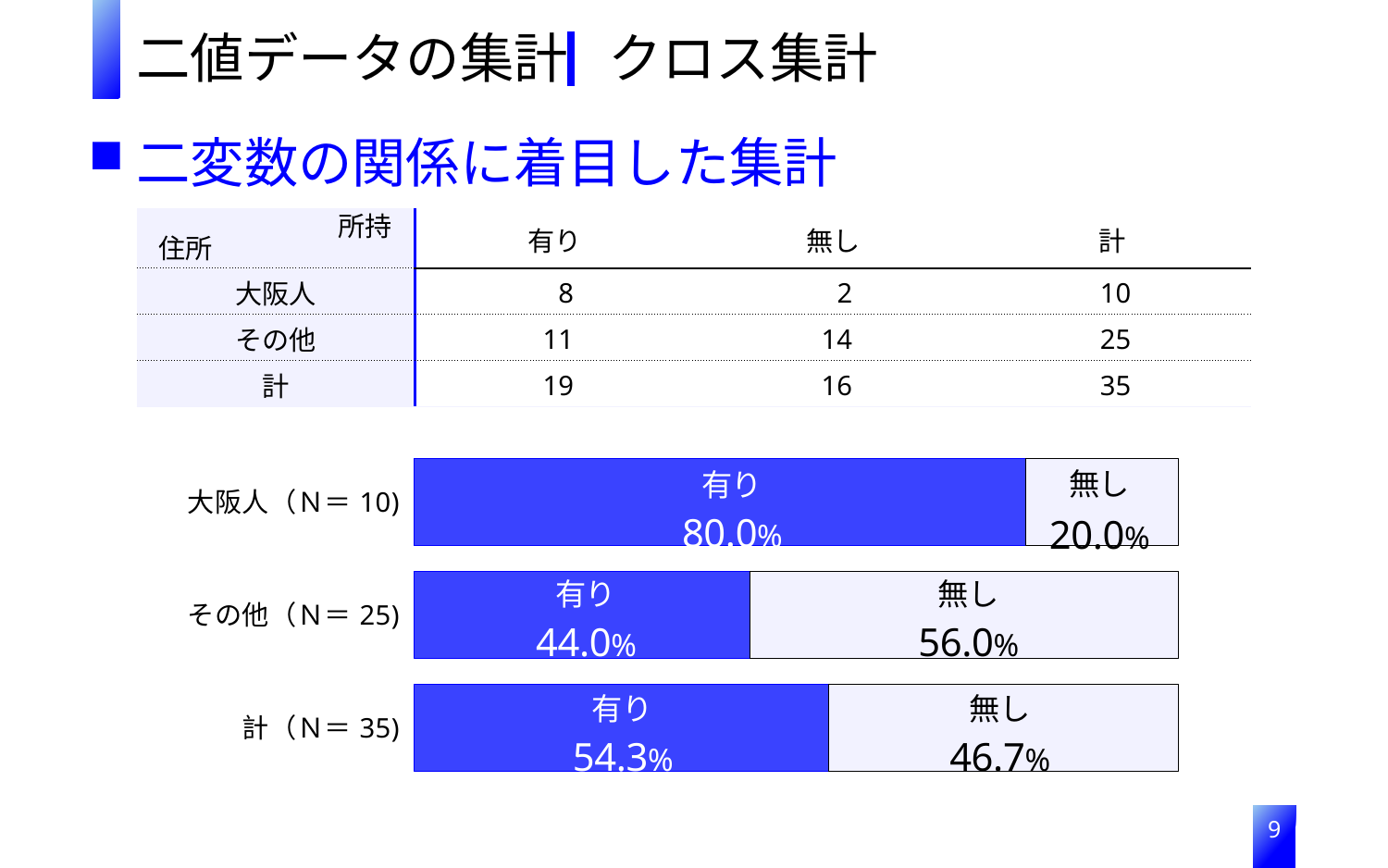
In the bar chart, what is the 無し percentage for 計 (N=35)? 46.7% In the bar chart, which row has the highest 有り percentage? 大阪人 (N=10) In the bar chart, which row has the lowest 有り percentage? その他 (N=25) In the bar chart, what is the difference between the 有り percentage for 大阪人 and the 有り percentage for その他? 36.0% In the bar chart, what is the 有り percentage for その他 (N=25)? 44.0% In the bar chart, what is the 無し percentage for その他 (N=25)? 56.0% In the bar chart, what is the 有り percentage for 大阪人 (N=10)? 80.0% What kind of chart is shown below the table on the slide? Stacked bar chart In the bar chart, what is the 無し percentage for 大阪人 (N=10)? 20.0% In the bar chart, is the 無し percentage larger for 大阪人 or for その他? その他 In the bar chart, what is the 有り percentage for 計 (N=35)? 54.3% How many bars are shown in the bar chart? 3